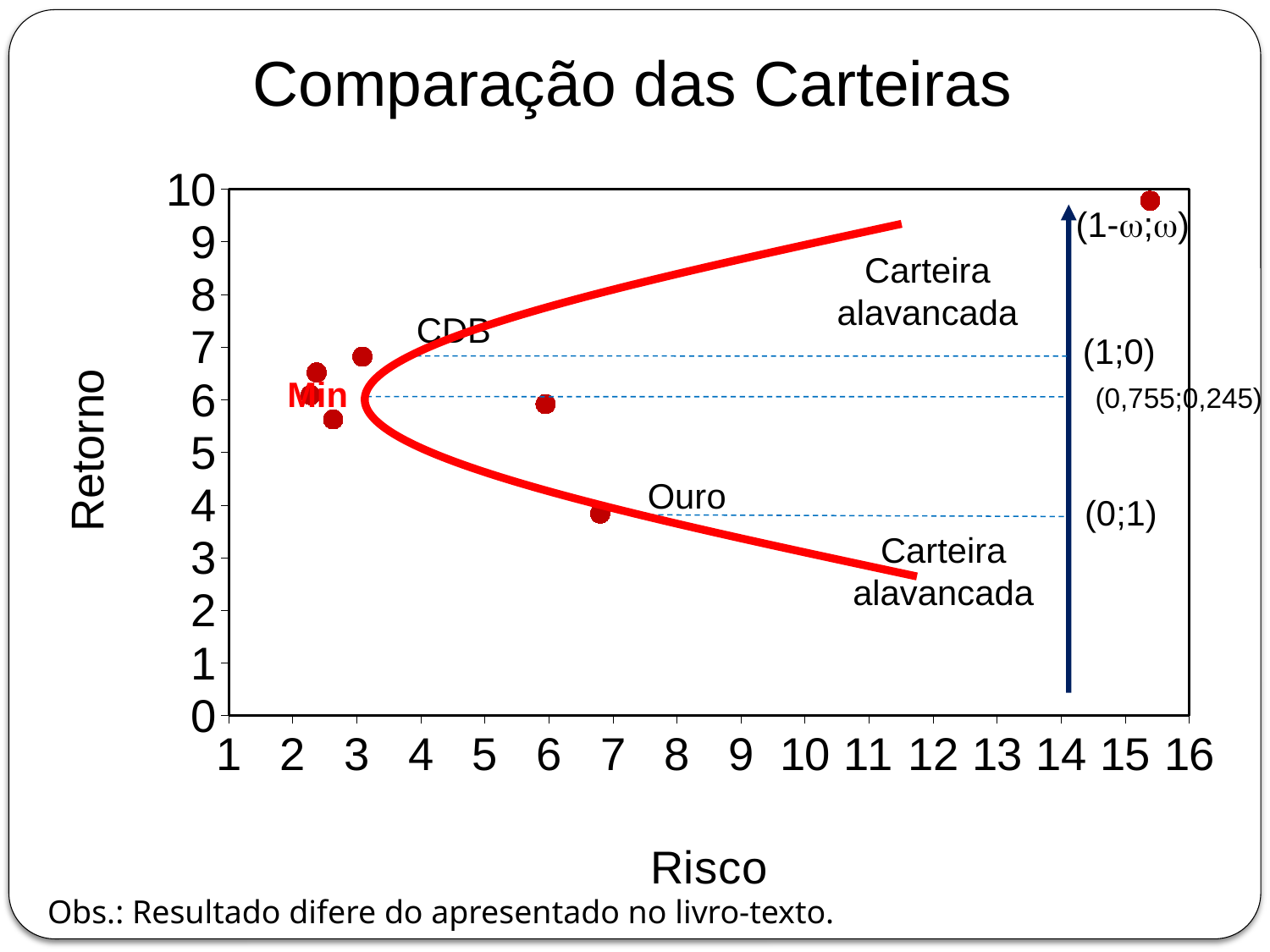
What kind of chart is shown on the slide? Scatter chart Is the Retorno value for CDB greater or less than 6? greater Which has the higher Retorno, CDB or Ouro? CDB Which has the higher Risco, CDB or Ouro? Ouro Is the Risco value for Ouro greater or less than 5? greater Is the Retorno value for Ouro greater or less than 5? less What is the title of the chart? Comparação das Carteiras What is the label of the horizontal axis? Risco What is the highest value shown on the Retorno axis? 10